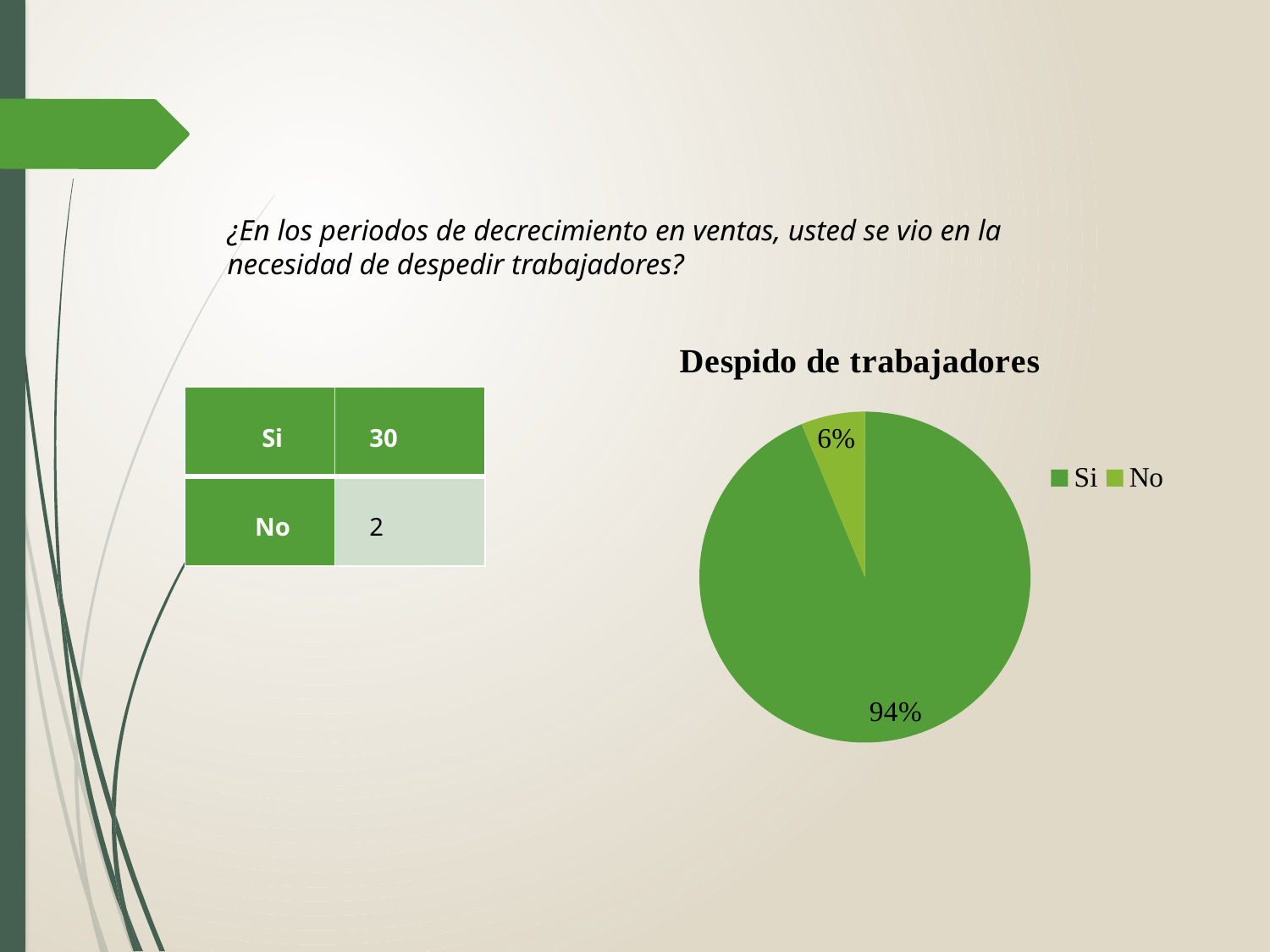
What percentage of the pie chart does the "Si" slice represent? 94% Which slice is larger in the pie chart, "Si" or "No"? Si What is the title of the pie chart? Despido de trabajadores How many entries does the legend of the pie chart list? 2 What percentage of the pie chart does the "No" slice represent? 6% How many slices does the pie chart have? 2 What type of chart is shown on the slide? pie chart What is the difference in percentage points between the "Si" and "No" slices? 88 Which category has the smallest slice in the pie chart? No Which category has the largest slice in the pie chart? Si Is the share for "Si" in the pie chart greater or less than 50%? greater What are the legend entries of the pie chart? Si, No